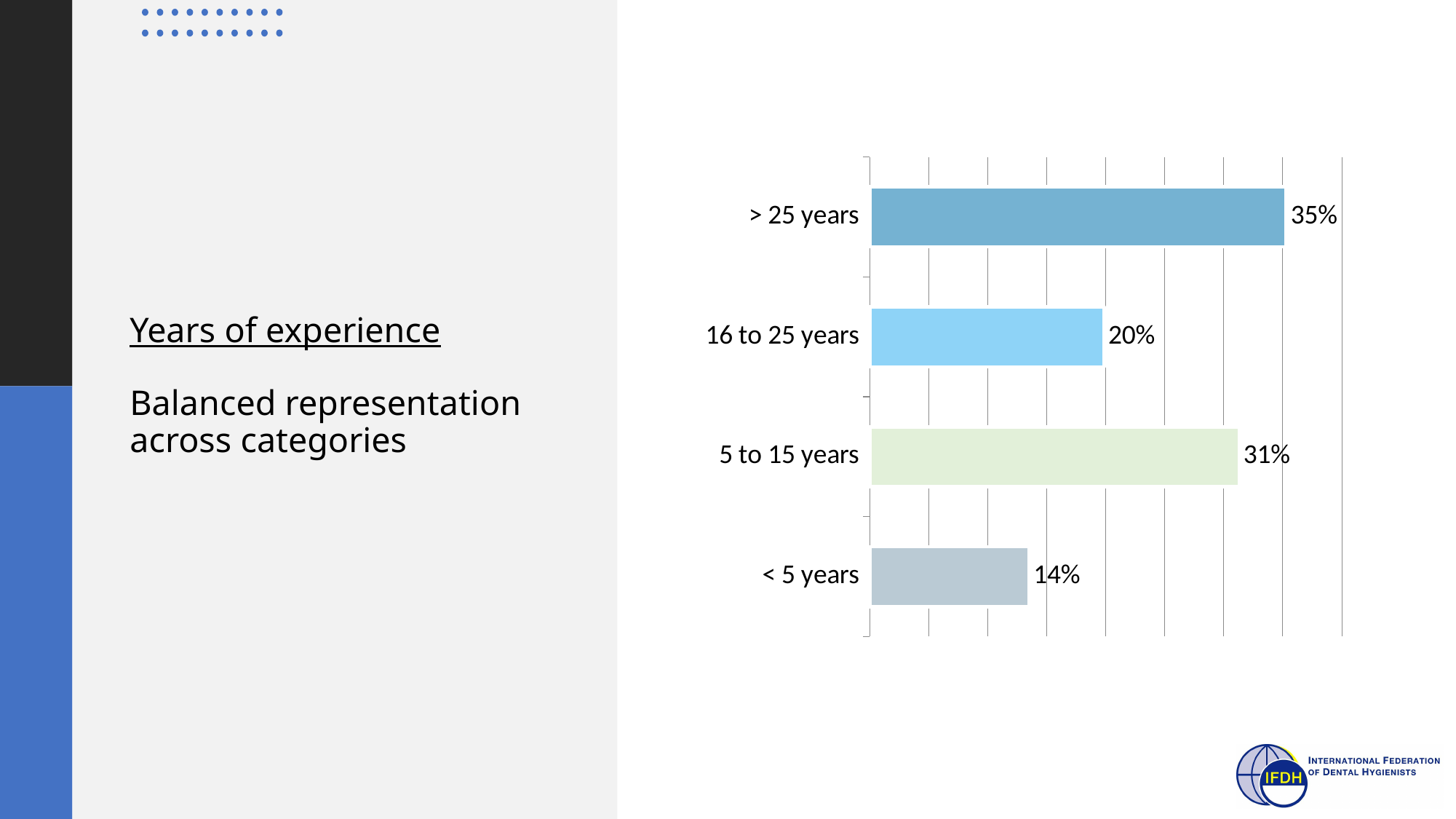
What is the value shown for the '5 to 15 years' category? 31% What is the difference between the '5 to 15 years' and '16 to 25 years' values? 11% What type of chart is shown on the slide? Bar chart What is the title of the chart section on the slide? Years of experience What is the difference between the '> 25 years' and '< 5 years' values? 21% What percentage of respondents have less than 5 years of experience? 14% Which is larger: the value for '5 to 15 years' or the value for '16 to 25 years'? 5 to 15 years What is the value shown for the '16 to 25 years' category? 20% Which years-of-experience category has the highest value? > 25 years Which years-of-experience category has the lowest value? < 5 years How many years-of-experience categories are shown in the chart? 4 What percentage of respondents have more than 25 years of experience? 35%